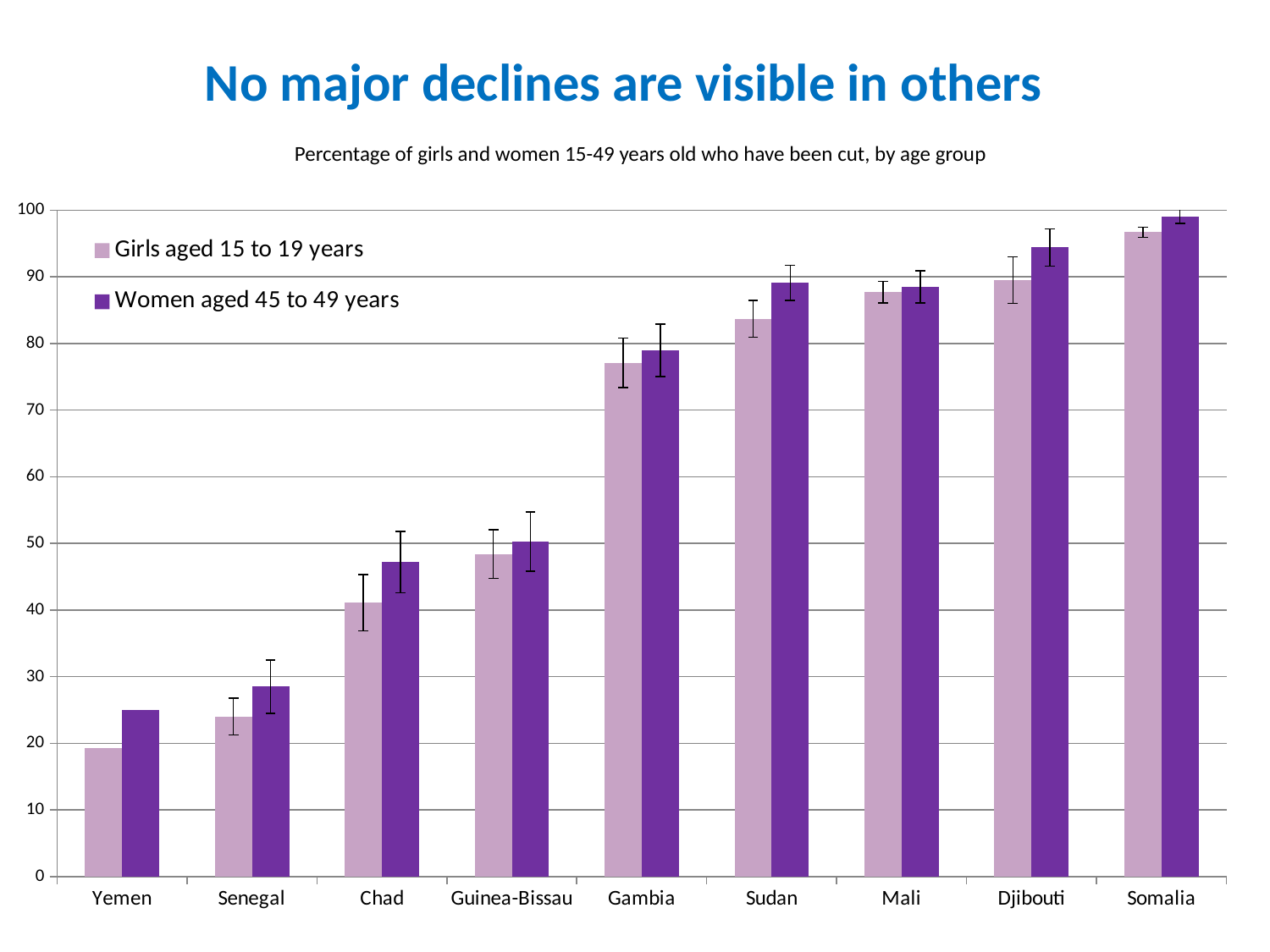
How many series does the chart's legend list? 2 Do the values for girls aged 15 to 19 years generally rise or fall from Yemen to Somalia along the x axis? Rise Which country has the highest value for girls aged 15 to 19 years? Somalia What is the title of the slide containing the chart? No major declines are visible in others Is the value for girls aged 15 to 19 years in Somalia greater or less than 90? greater How many countries are shown on the x axis of the chart? 9 Which country has the lowest value for women aged 45 to 49 years? Yemen Which is larger: the value for women aged 45 to 49 years in Djibouti or in Sudan? Djibouti Is the value for women aged 45 to 49 years in Sudan greater or less than 80? greater Is the value for girls aged 15 to 19 years in Yemen greater or less than 20? less What kind of chart is shown on the slide? Bar chart